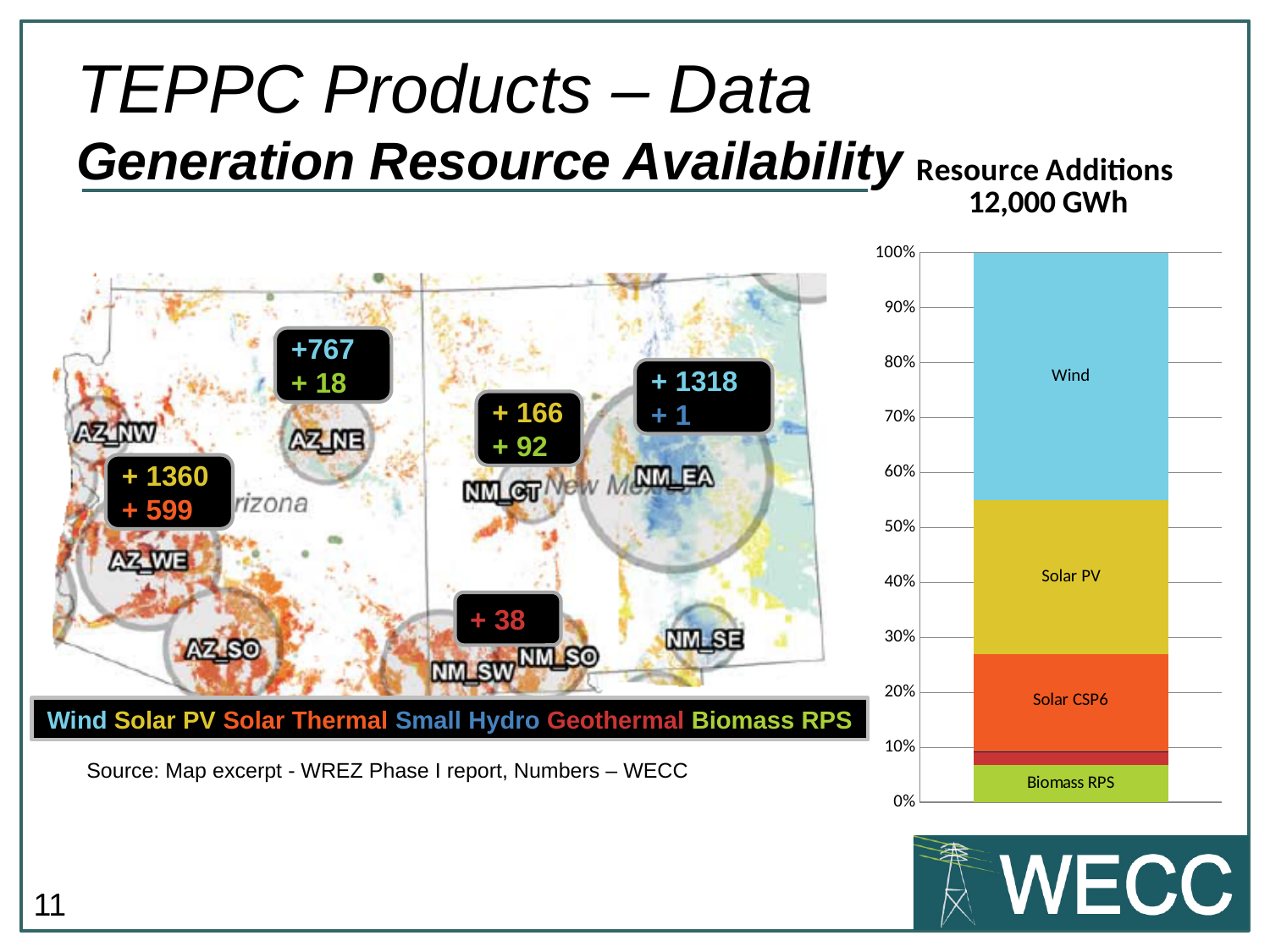
In the Resource Additions chart, is the share for Solar CSP6 greater or less than 20%? less How many segments in the Resource Additions stacked bar have a readable text label? 4 In the Resource Additions chart, which labeled segment is at the top of the stacked bar? Wind In the Resource Additions chart, is the share for Solar PV greater or less than 20%? greater What kind of chart is shown on the right side of the slide under 'Resource Additions 12,000 GWh'? stacked bar chart In the Resource Additions chart, which has the larger share, Wind or Solar PV? Wind In the Resource Additions chart, is the share for Biomass RPS greater or less than 10%? less In the Resource Additions chart, which labeled segment takes up the largest share of the bar? Wind In the Resource Additions chart, which labeled segment is at the bottom of the stacked bar? Biomass RPS In the Resource Additions chart, which has the larger share, Solar PV or Solar CSP6? Solar PV What is the highest value shown on the vertical axis of the Resource Additions chart? 100%